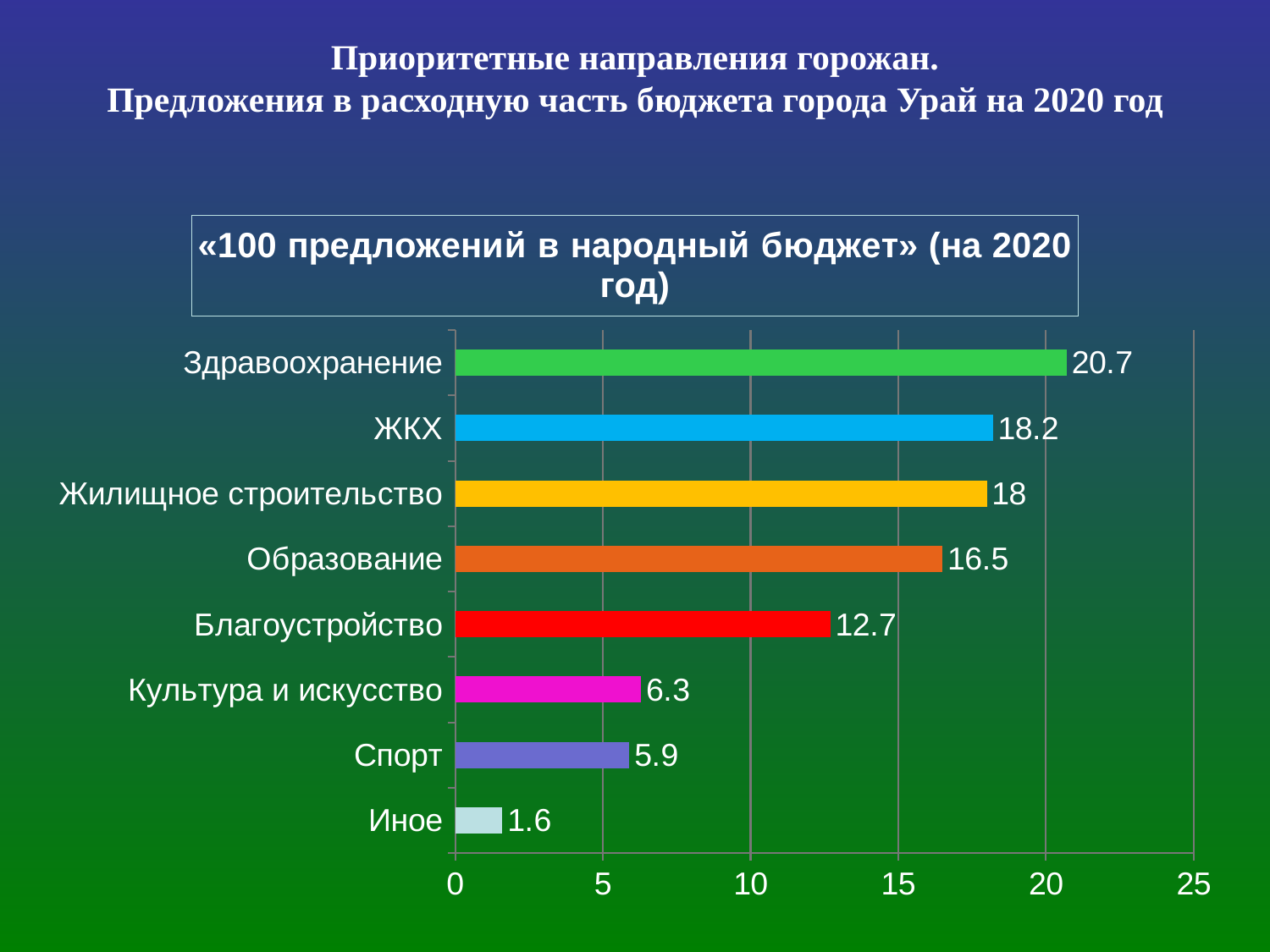
What is the value for Благоустройство? 12.7 What is the value for Спорт? 5.9 What is the difference between the values for Здравоохранение and ЖКХ? 2.5 Which category has the lowest value? Иное Which category has the highest value? Здравоохранение What kind of chart is shown on the slide? Bar chart What is the value for Здравоохранение? 20.7 What is the difference between the values for Образование and Благоустройство? 3.8 What is the title of the chart? «100 предложений в народный бюджет» (на 2020 год) How many categories are shown in the chart? 8 Which is larger, the value for Культура и искусство or the value for Спорт? Культура и искусство What is the value for ЖКХ? 18.2